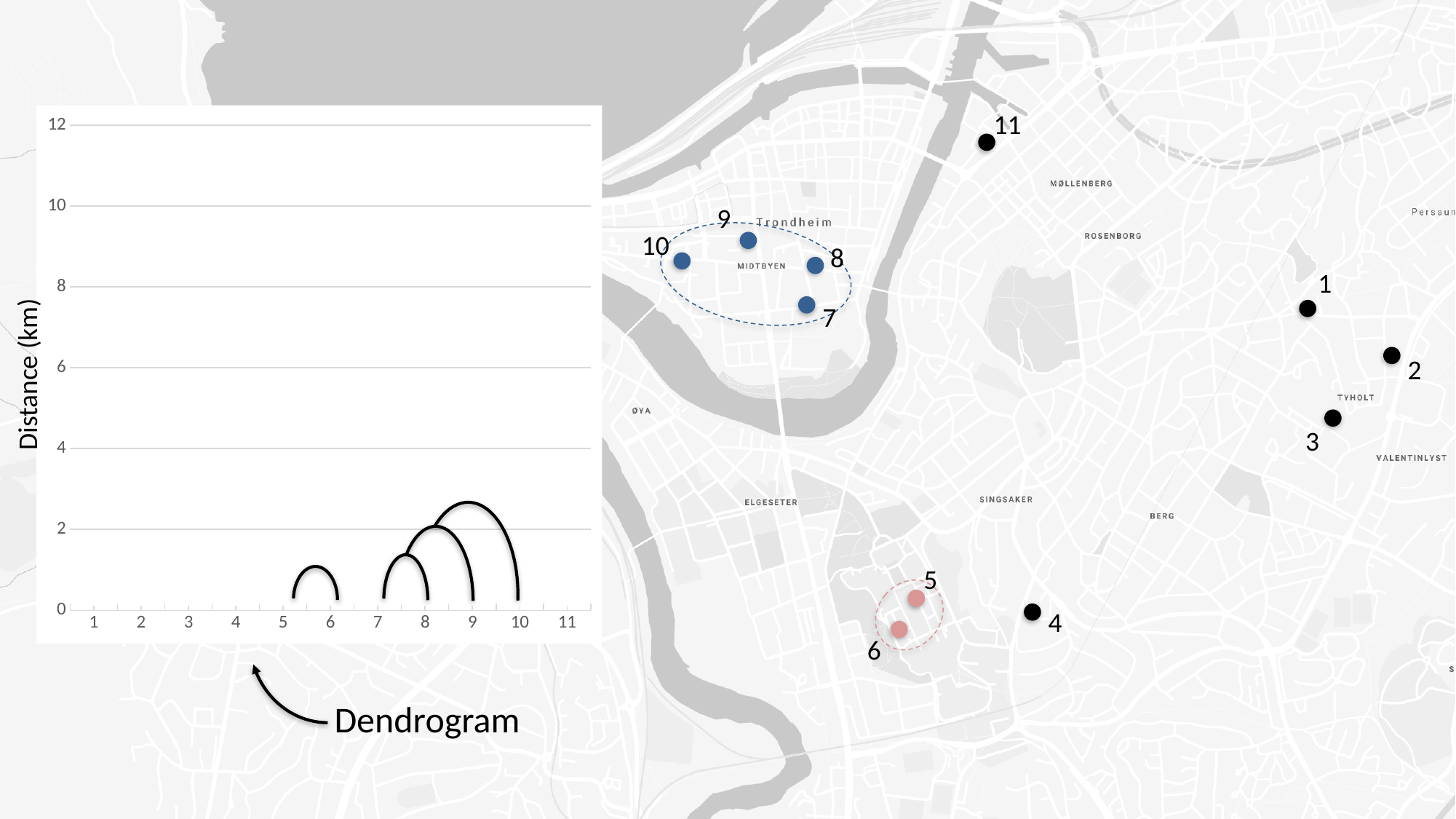
Is the distance at which point 10 joins the cluster in the dendrogram greater or less than 2? greater Is the distance at which points 5 and 6 are joined in the dendrogram greater or less than 2? less Which merge occurs at a greater distance in the dendrogram: the one joining points 5 and 6, or the one joining point 9 to the cluster? The one joining point 9 Which point joins the 7-8-9 cluster at the greatest distance in the dendrogram? 10 Which two points are joined by the leftmost arc in the dendrogram? 5 and 6 What is the highest value shown on the vertical axis of the dendrogram? 12 How many points are labelled along the x axis of the dendrogram? 11 How many arcs (merges) are drawn in the dendrogram? 4 What is the label of the vertical axis of the dendrogram? Distance (km) Is the highest merge in the dendrogram greater or less than 4 km? less How many points on the dendrogram's x axis are not connected by any arc? 5 What kind of chart is shown on the left of the slide? Dendrogram